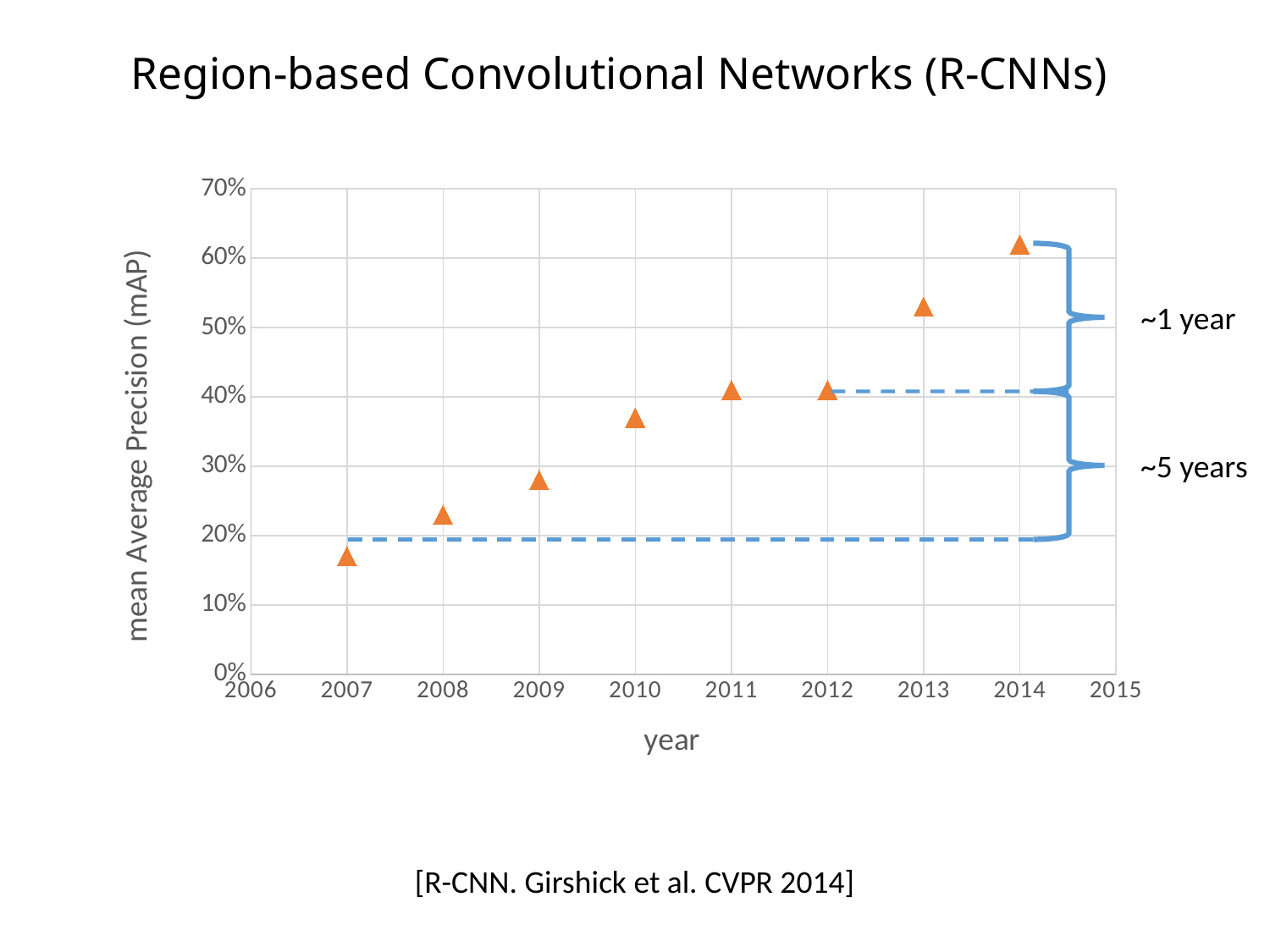
Do the mAP values generally rise or fall from 2007 to 2014? rise How many data points are plotted on the chart? 8 Which year has the highest mean Average Precision? 2014 Is the value for 2007 greater or less than 20%? less Is the value for 2009 greater or less than 30%? less Is the value for 2014 greater or less than 60%? greater What is the label of the vertical axis? mean Average Precision (mAP) Which year has a higher mAP, 2010 or 2013? 2013 What kind of chart is shown on the slide? scatter chart Which year has the lowest mean Average Precision? 2007